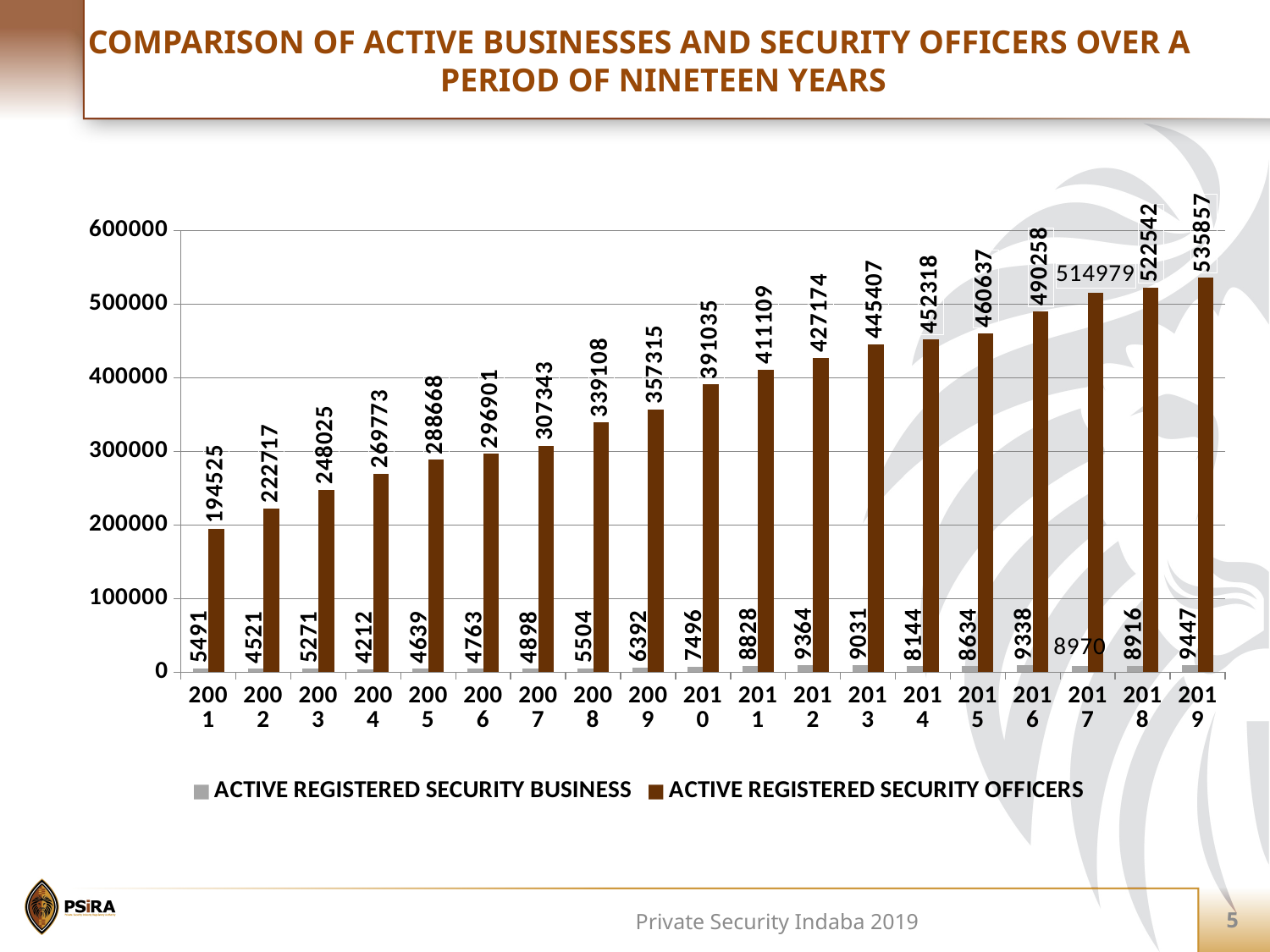
Which year has the highest value for ACTIVE REGISTERED SECURITY OFFICERS? 2019 How many series does the legend list? 2 What is the value for ACTIVE REGISTERED SECURITY OFFICERS in 2019? 535857 What is the value for ACTIVE REGISTERED SECURITY BUSINESS in 2017? 8970 What is the difference between the ACTIVE REGISTERED SECURITY OFFICERS values for 2019 and 2001? 341332 Which year has the lowest value for ACTIVE REGISTERED SECURITY BUSINESS? 2004 Is the value for ACTIVE REGISTERED SECURITY OFFICERS in 2016 greater or less than 400000? greater How many years are shown on the x axis? 19 What is the value for ACTIVE REGISTERED SECURITY OFFICERS in 2010? 391035 Which is larger, the ACTIVE REGISTERED SECURITY BUSINESS value for 2012 or for 2014? 2012 What kind of chart is shown on the slide? bar chart What is the value for ACTIVE REGISTERED SECURITY BUSINESS in 2001? 5491